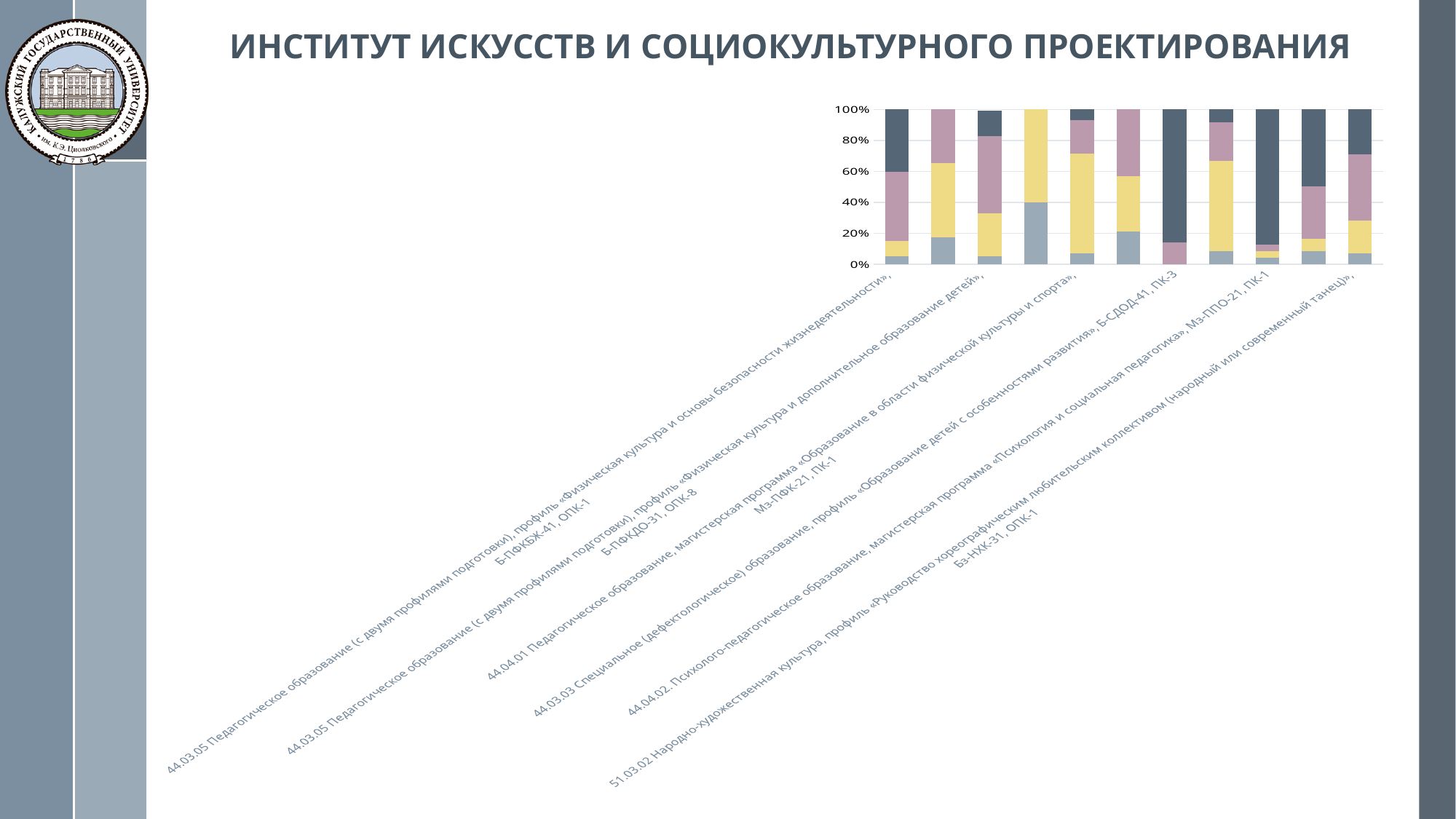
Is the dark top segment larger in the seventh bar from the left or in the first bar from the left? Seventh bar In the first bar from the left, is the light grey-blue bottom segment greater or less than 20%? less How many bars does the chart contain? 11 What kind of chart is shown on the slide? Stacked bar chart In the seventh bar from the left, is the dark top segment greater or less than 80%? greater What is the highest value shown on the vertical axis of the chart? 100% Is the yellow segment larger in the fourth bar from the left or in the ninth bar from the left? Fourth bar In the fourth bar from the left, is the yellow segment greater or less than 40%? greater How many differently coloured segments make up each bar in the chart? 4